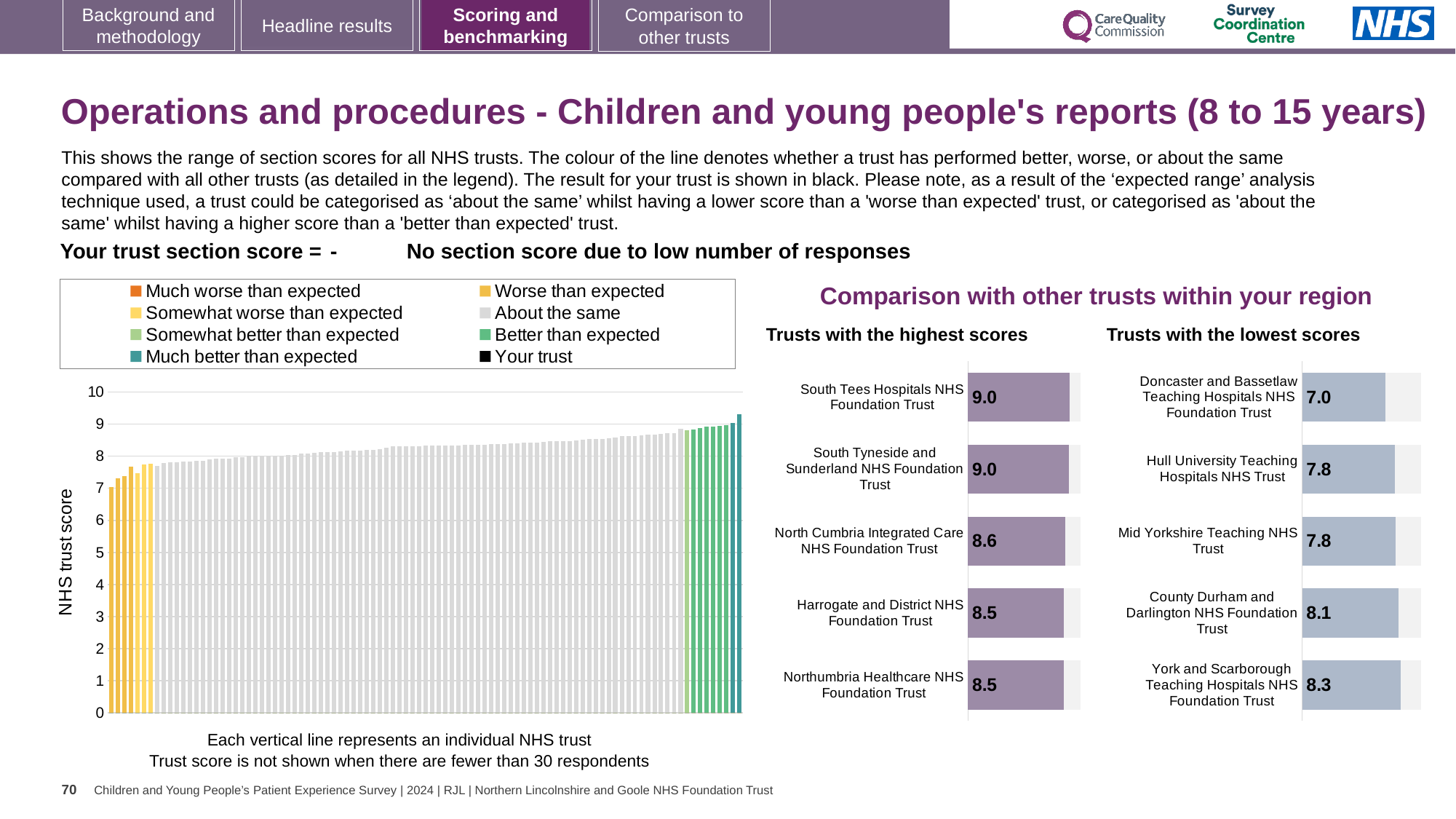
Which has the higher score: North Cumbria Integrated Care NHS Foundation Trust in the highest scores chart or County Durham and Darlington NHS Foundation Trust in the lowest scores chart? North Cumbria Integrated Care NHS Foundation Trust In the 'Trusts with the lowest scores' chart, what is the difference between the scores for York and Scarborough Teaching Hospitals NHS Foundation Trust and Doncaster and Bassetlaw Teaching Hospitals NHS Foundation Trust? 1.3 In the 'Trusts with the lowest scores' chart, what is the score for Doncaster and Bassetlaw Teaching Hospitals NHS Foundation Trust? 7.0 In the large 'NHS trust score' chart on the left, do the bar values rise or fall from left to right? rise In the large 'NHS trust score' chart on the left, is the value of the leftmost bar greater or less than 8? less In the 'Trusts with the lowest scores' chart, which trust has the highest score? York and Scarborough Teaching Hospitals NHS Foundation Trust What is the difference between the score for South Tees Hospitals NHS Foundation Trust in the highest scores chart and the score for Doncaster and Bassetlaw Teaching Hospitals NHS Foundation Trust in the lowest scores chart? 2.0 How many trusts are shown in the 'Trusts with the highest scores' chart? 5 In the 'Trusts with the lowest scores' chart, which trust has the lowest score? Doncaster and Bassetlaw Teaching Hospitals NHS Foundation Trust In the 'Trusts with the highest scores' chart, what is the score for Harrogate and District NHS Foundation Trust? 8.5 How many entries does the legend above the large 'NHS trust score' chart list? 8 In the 'Trusts with the highest scores' chart, what is the score for North Cumbria Integrated Care NHS Foundation Trust? 8.6